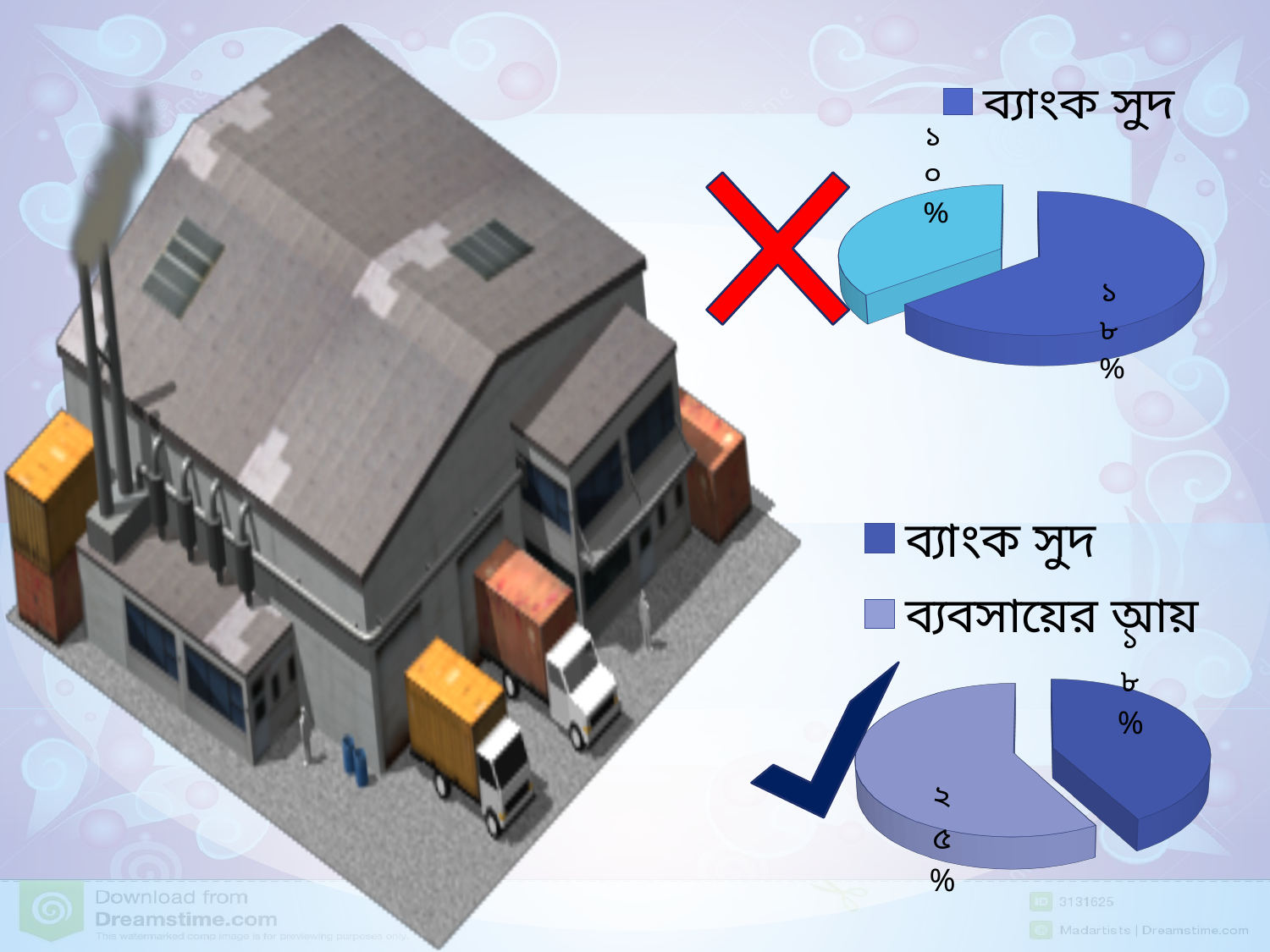
In the bottom pie chart, which slice is larger, ব্যাংক সুদ or ব্যবসায়ের আয়? ব্যবসায়ের আয় In the top pie chart, which slice is larger, the dark blue slice or the light blue slice? The dark blue slice How many slices does the top pie chart have? 2 In the top pie chart, what value is labelled on the light blue slice? ১০% In the bottom pie chart, what value is shown for ব্যবসায়ের আয়? ২৫% How many entries does the legend of the top pie chart list? 1 What kind of chart is the bottom chart on the right of the slide? Pie chart How many entries does the legend of the bottom pie chart list? 2 What kind of chart is the top chart on the right of the slide? Pie chart In the top pie chart, what value is labelled on the dark blue ব্যাংক সুদ slice? ১৮%